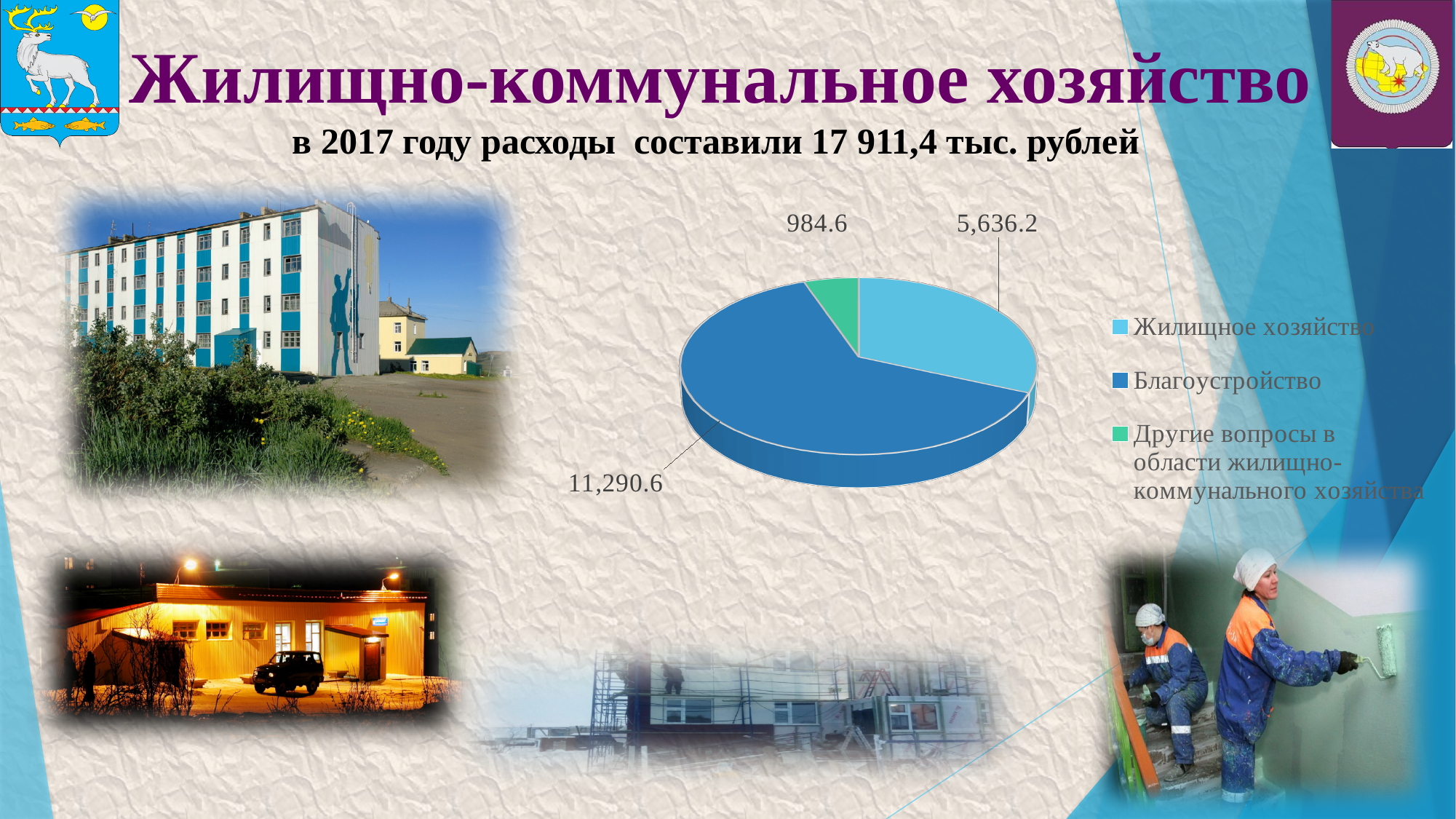
What colour is the slice for Другие вопросы в области жилищно-коммунального хозяйства? Green What value is shown for Жилищное хозяйство in the pie chart? 5,636.2 Which is larger: the value for Жилищное хозяйство or the value for Другие вопросы в области жилищно-коммунального хозяйства? Жилищное хозяйство How many slices does the pie chart have? 3 What is the difference between the values for Жилищное хозяйство and Другие вопросы в области жилищно-коммунального хозяйства? 4,651.6 What value is shown for Другие вопросы в области жилищно-коммунального хозяйства in the pie chart? 984.6 What is the total of all three values in the pie chart? 17,911.4 What kind of chart is shown on the slide? Pie chart What is the difference between the values for Благоустройство and Жилищное хозяйство? 5,654.4 Which category has the smallest slice in the pie chart? Другие вопросы в области жилищно-коммунального хозяйства Which category has the largest slice in the pie chart? Благоустройство What value is shown for Благоустройство in the pie chart? 11,290.6